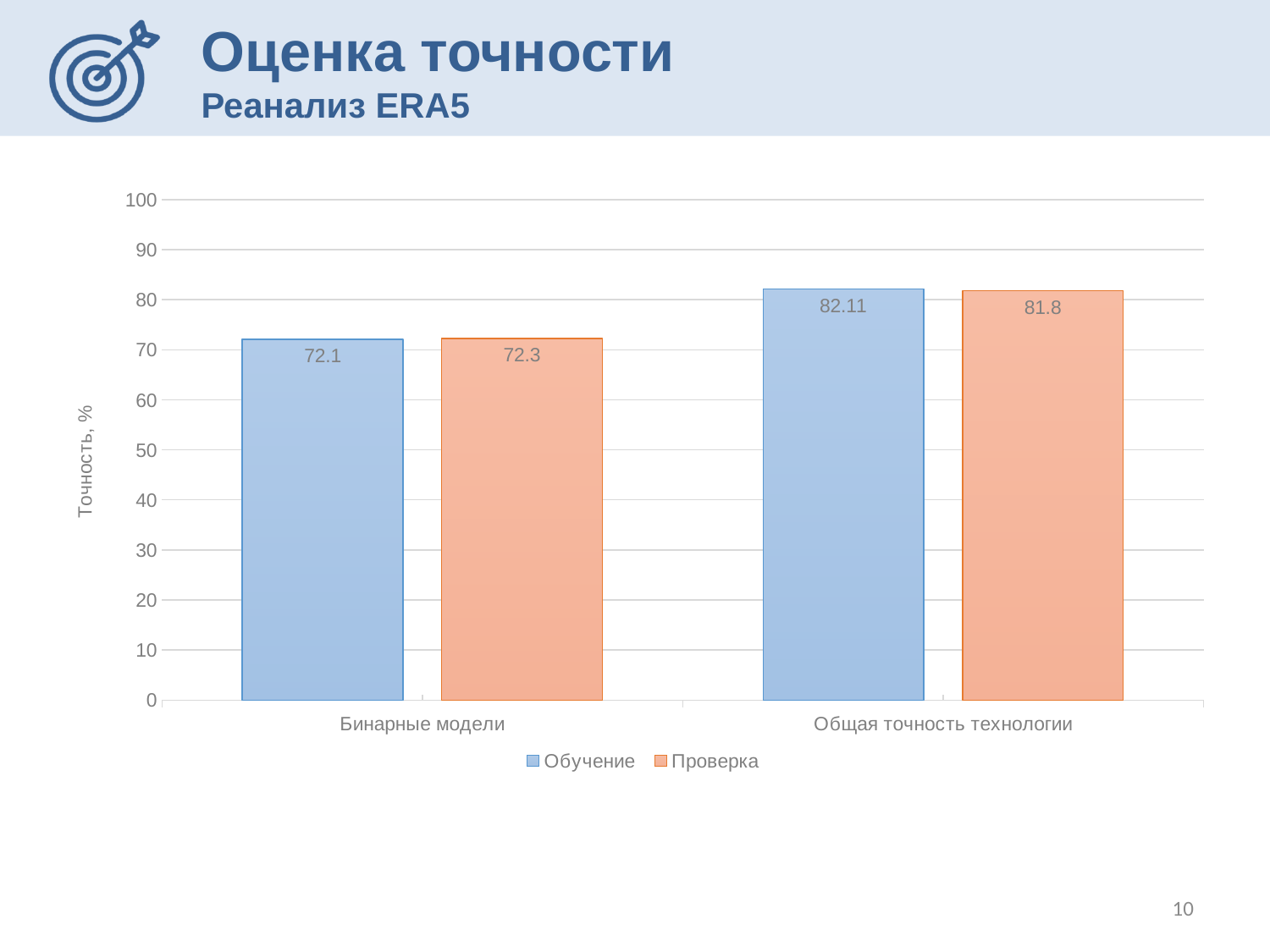
Which bar has the highest value on the chart? Обучение, Общая точность технологии (82.11) What is the value for Проверка in the Бинарные модели category? 72.3 Which is larger: the Проверка value for Бинарные модели or the Проверка value for Общая точность технологии? Общая точность технологии Which bar has the lowest value on the chart? Обучение, Бинарные модели (72.1) How many categories are shown on the x axis? 2 What is the difference between the Обучение values for Общая точность технологии and Бинарные модели? 10.01 How many series does the legend list? 2 What is the title of the vertical axis? Точность, % What kind of chart is shown on the slide? bar chart Is the Обучение value for Бинарные модели greater or less than 80? less What is the value for Проверка in the Общая точность технологии category? 81.8 What is the value for Обучение in the Бинарные модели category? 72.1